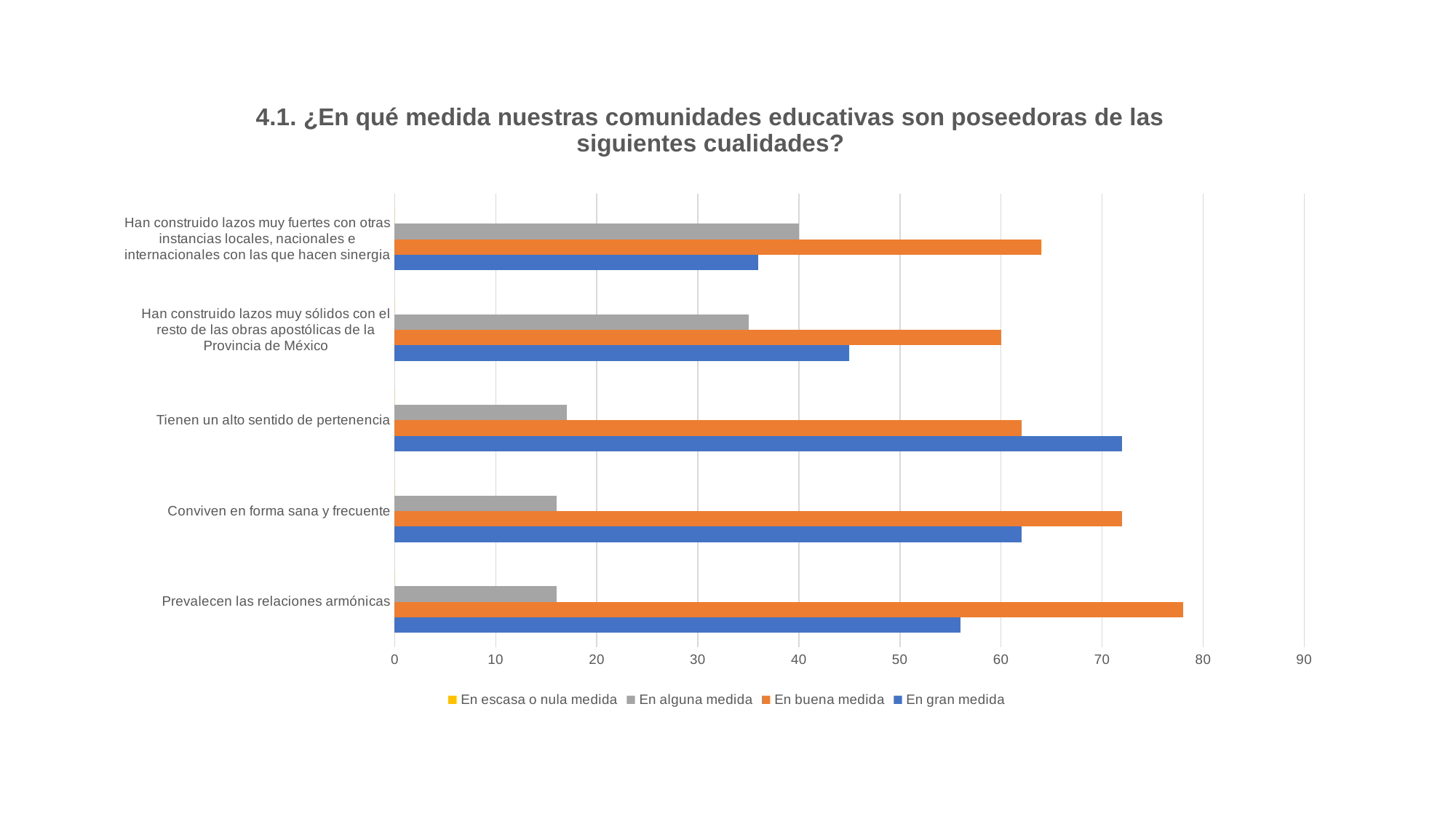
Which colour represents the series 'En gran medida' in the legend? blue Is the value of 'En alguna medida' for 'Tienen un alto sentido de pertenencia' greater or less than 20? less What kind of chart is shown on the slide? bar chart Which category has the highest value for 'En gran medida'? Tienen un alto sentido de pertenencia For 'Conviven en forma sana y frecuente', which is larger: 'En buena medida' or 'En gran medida'? En buena medida Which category has the highest value for 'En buena medida'? Prevalecen las relaciones armónicas Which category has the lowest value for 'En gran medida'? Han construido lazos muy fuertes con otras instancias locales, nacionales e internacionales con las que hacen sinergia How many series does the legend list? 4 What is the value of 'En buena medida' for 'Han construido lazos muy sólidos con el resto de las obras apostólicas de la Provincia de México'? 60 What is the value of 'En alguna medida' for 'Han construido lazos muy fuertes con otras instancias locales, nacionales e internacionales con las que hacen sinergia'? 40 Is the value of 'En buena medida' for 'Prevalecen las relaciones armónicas' greater or less than 70? greater How many categories (qualities) are plotted on the chart? 5